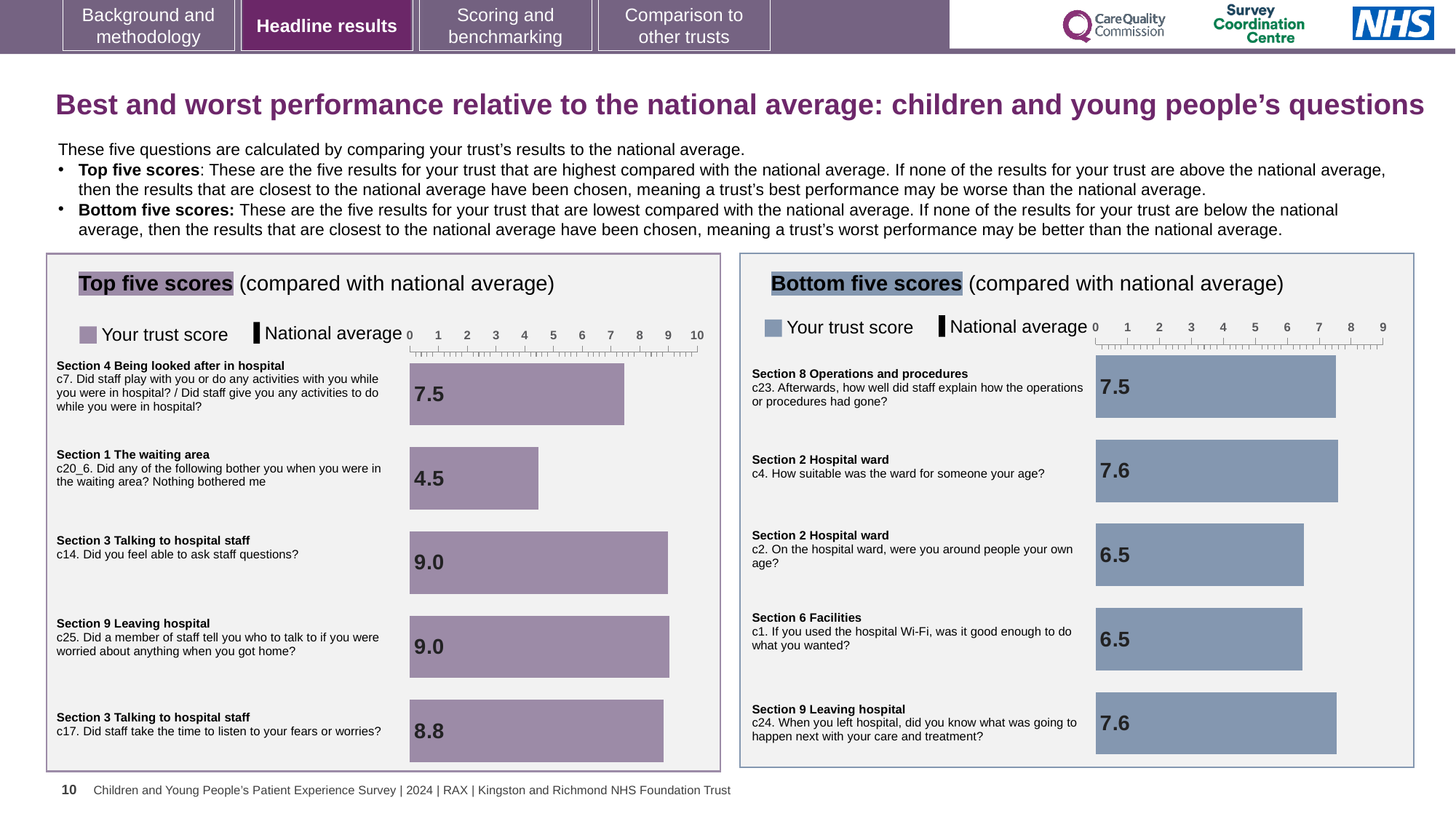
In the Top five scores chart, which question has the lowest trust score? c20_6 (Section 1 The waiting area) In the Top five scores chart, is the trust score for c7 greater or less than 5? greater In the Top five scores chart, what is the trust score for c14 'Did you feel able to ask staff questions?' 9.0 In the Bottom five scores chart, which has the higher trust score: c4 'How suitable was the ward for someone your age?' or c2 'On the hospital ward, were you around people your own age?' c4 In the Bottom five scores chart, what is the trust score for c23 'Afterwards, how well did staff explain how the operations or procedures had gone?' 7.5 In the Top five scores chart, what is the trust score for c20_6 'Did any of the following bother you when you were in the waiting area? Nothing bothered me'? 4.5 In the Bottom five scores chart, what is the difference between the trust scores for c4 and c1? 1.1 In the Top five scores chart, what is the difference between the trust scores for c17 and c20_6? 4.3 How many entries does the legend of the Top five scores chart list? 2 In the Bottom five scores chart, what is the trust score for c2 'On the hospital ward, were you around people your own age?' 6.5 What type of chart is used in the Bottom five scores panel? Bar chart How many questions are shown in the Top five scores chart? 5